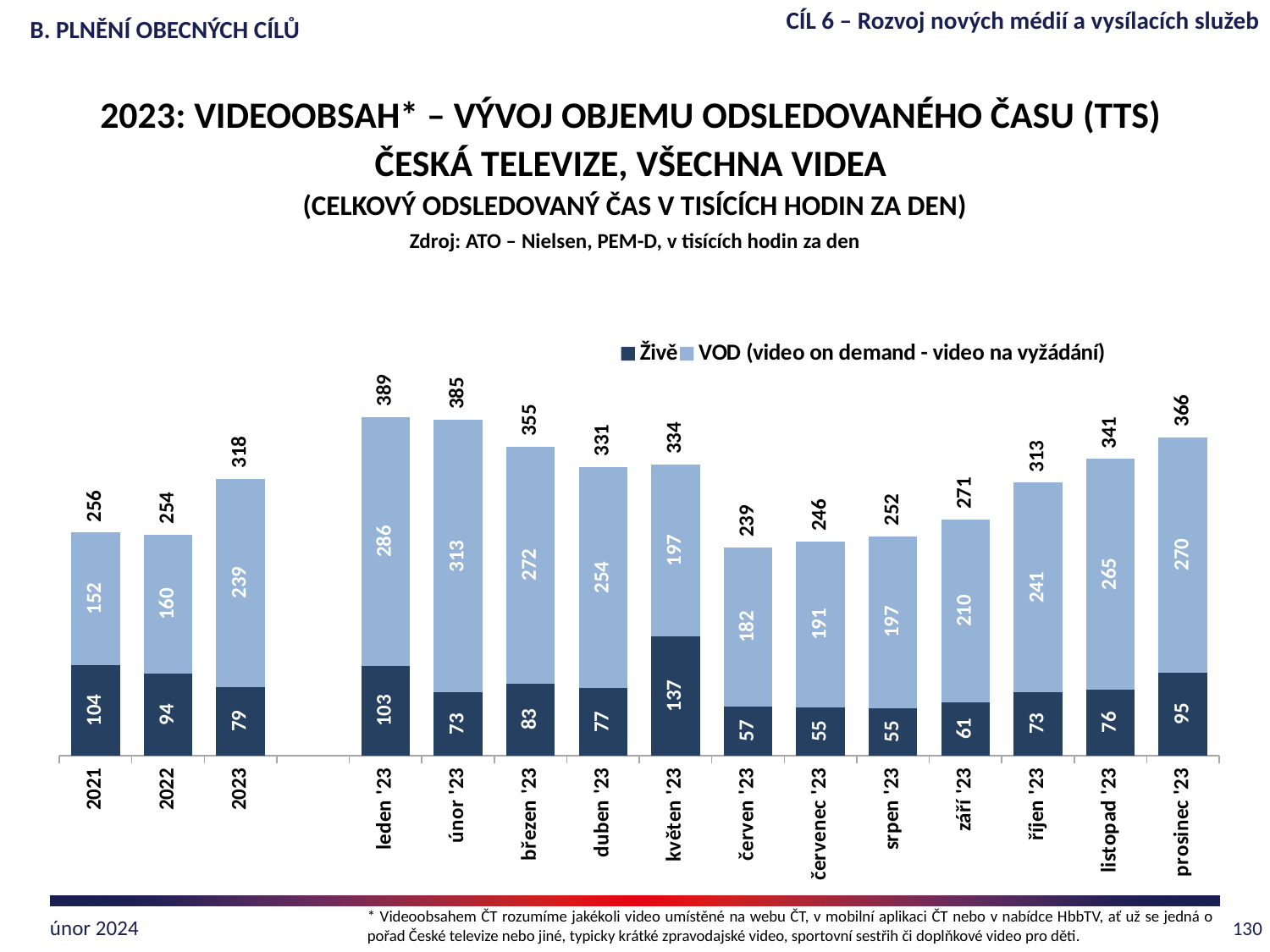
Is the VOD value larger for březen '23 or duben '23? březen '23 What type of chart is shown on the slide? stacked bar chart What is the total of the stacked bar for prosinec '23? 366 Which month of 2023 has the highest Živě value? květen '23 How many series does the legend list? 2 Which month of 2023 has the highest total? leden '23 How many bars are plotted in the chart? 15 What is the VOD value for únor '23? 313 What is the Živě value for 2021? 104 What is the difference between the totals for 2023 and 2022? 64 What is the Živě value for září '23? 61 Which month of 2023 has the lowest total? červen '23